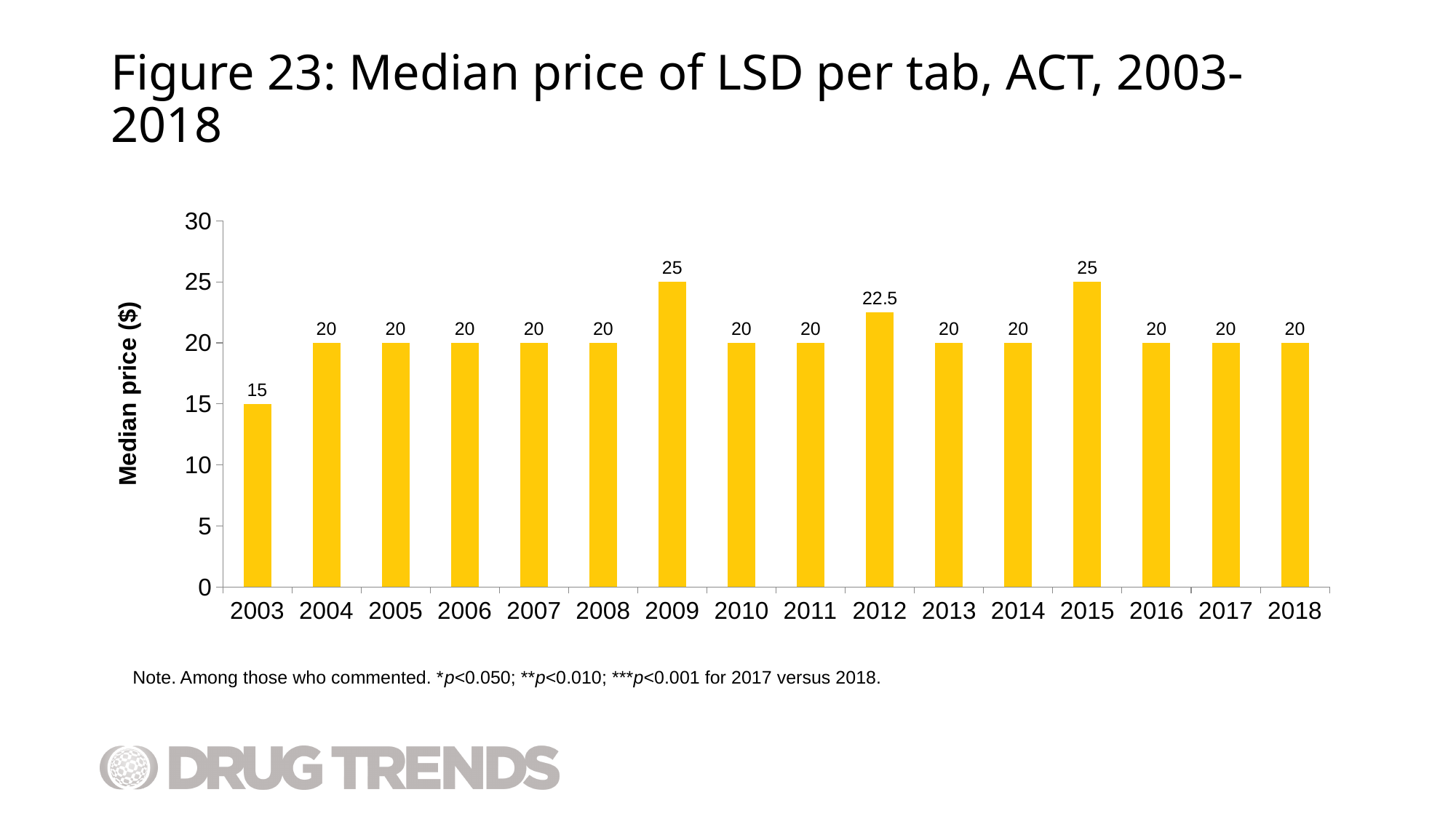
What is the title of the chart on the slide? Figure 23: Median price of LSD per tab, ACT, 2003-2018 How many years are shown on the x axis of the chart? 16 What is the median price of LSD per tab in 2018? 20 Is the median price for 2009 greater or less than 20? greater What is the difference between the median price in 2012 and the median price in 2011? 2.5 What is the median price of LSD per tab in 2012? 22.5 Which is larger, the median price in 2015 or the median price in 2016? 2015 What kind of chart is shown on the slide? Bar chart What is the median price of LSD per tab in 2003? 15 What is the difference between the median price in 2009 and the median price in 2003? 10 Which year has the lowest median price of LSD per tab? 2003 What is the label of the y axis of the chart? Median price ($)